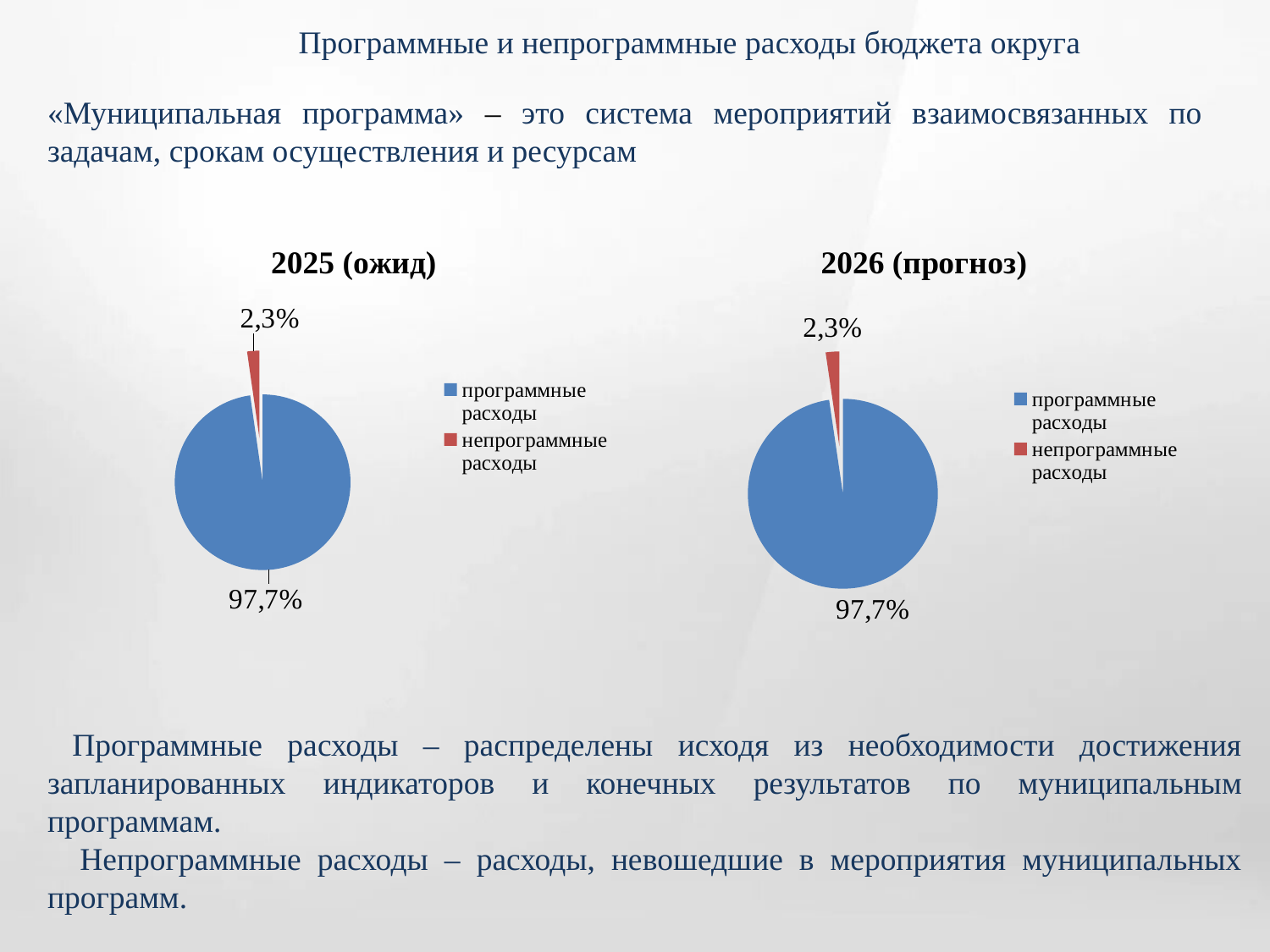
In the "2025 (ожид)" chart, which category has the largest slice? программные расходы How many entries does the legend of the "2025 (ожид)" chart list? 2 What type of chart is the "2025 (ожид)" chart? pie chart In the "2026 (прогноз)" chart, what share is shown for непрограммные расходы? 2,3% In the "2026 (прогноз)" chart, what share is shown for программные расходы? 97,7% In the "2026 (прогноз)" chart, which category has the smallest slice? непрограммные расходы In the "2026 (прогноз)" chart, which is larger: программные расходы or непрограммные расходы? программные расходы In the "2025 (ожид)" chart, what is the difference in percentage points between программные расходы and непрограммные расходы? 95,4 In the "2026 (прогноз)" chart, what colour is the slice for непрограммные расходы? red How many slices does the "2026 (прогноз)" pie chart have? 2 In the "2025 (ожид)" chart, what share is shown for программные расходы? 97,7% In the "2025 (ожид)" chart, what share is shown for непрограммные расходы? 2,3%